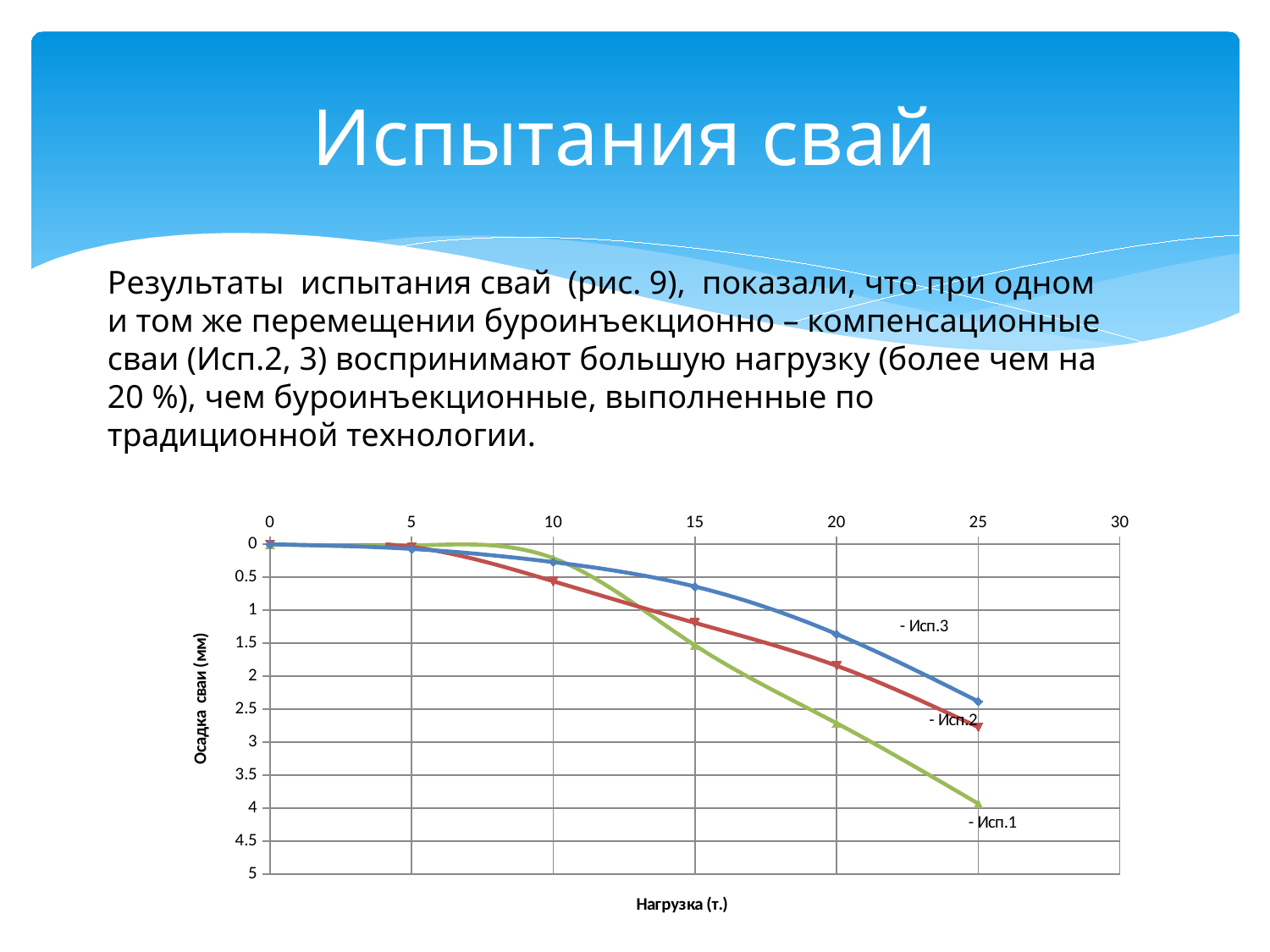
How does the settlement of each pile change as the load increases along the x axis? It increases Is the settlement of Исп.3 at a load of 20 t greater or less than 2 mm? less Which series shows the smallest settlement at a load of 25 t? Исп.3 What kind of chart is shown on the slide? Line chart Is the settlement of Исп.2 at a load of 25 t greater or less than 2.5 mm? greater How many series (test piles) are plotted on the chart? 3 Which series shows the largest settlement at a load of 25 t? Исп.1 At a load of 20 t, which series has the larger settlement, Исп.1 or Исп.3? Исп.1 What is the title of the vertical axis of the chart? Осадка сваи (мм) Is the settlement of Исп.3 at a load of 25 t greater or less than 3 mm? less What is the title of the horizontal axis of the chart? Нагрузка (т.)